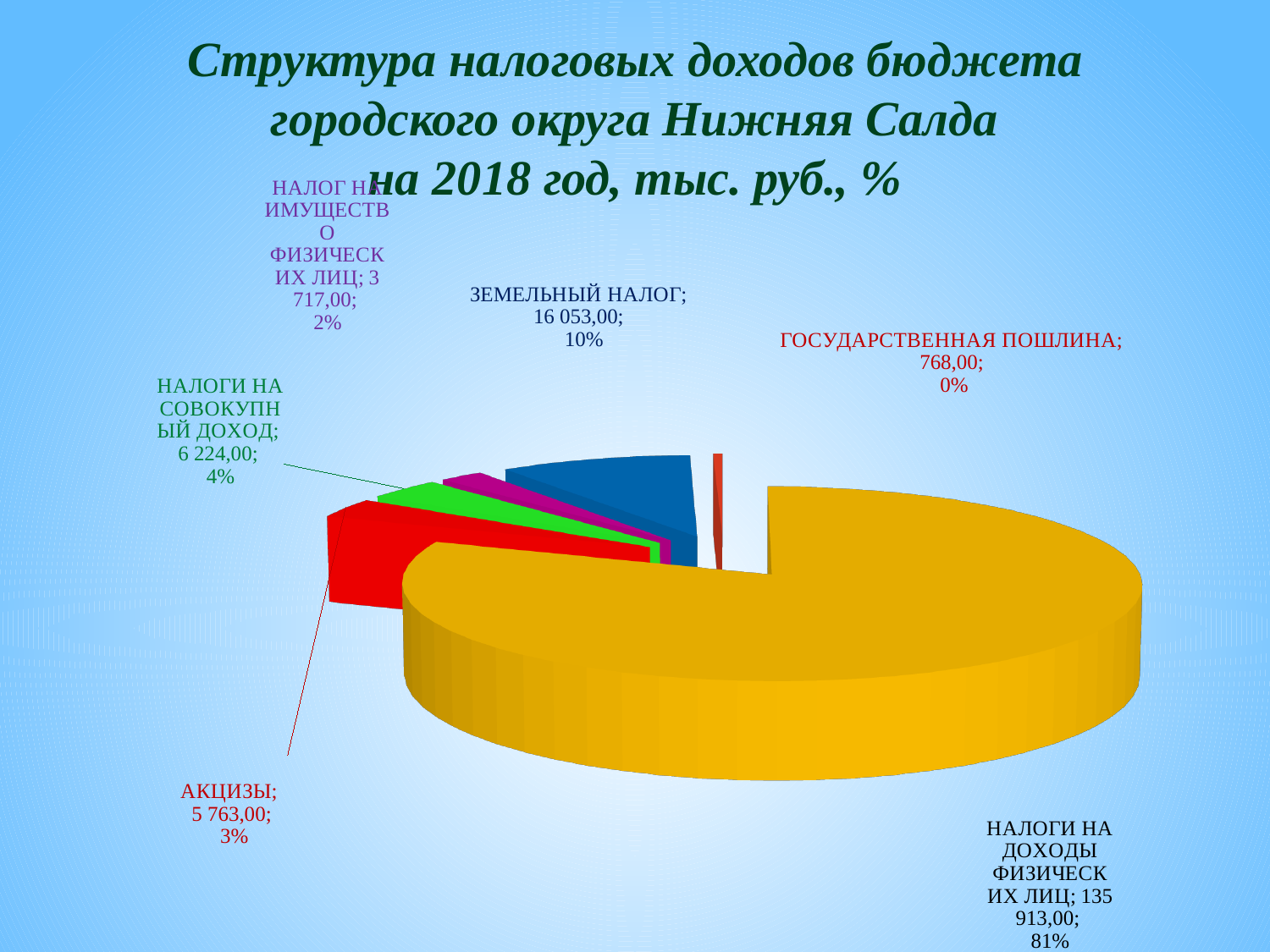
What is the difference between the values for ЗЕМЕЛЬНЫЙ НАЛОГ and НАЛОГИ НА СОВОКУПНЫЙ ДОХОД? 9 829,00 What is the value for ЗЕМЕЛЬНЫЙ НАЛОГ? 16 053,00 What year does the chart title refer to? 2018 What is the value for АКЦИЗЫ? 5 763,00 What share of the pie does НАЛОГИ НА ДОХОДЫ ФИЗИЧЕСКИХ ЛИЦ represent? 81% What is the value for ГОСУДАРСТВЕННАЯ ПОШЛИНА? 768,00 Which category has the largest slice of the pie? НАЛОГИ НА ДОХОДЫ ФИЗИЧЕСКИХ ЛИЦ Which is larger, the value for АКЦИЗЫ or the value for НАЛОГ НА ИМУЩЕСТВО ФИЗИЧЕСКИХ ЛИЦ? АКЦИЗЫ What percentage is shown for НАЛОГИ НА СОВОКУПНЫЙ ДОХОД? 4% What kind of chart is shown on the slide? pie chart Which category has the smallest slice of the pie? ГОСУДАРСТВЕННАЯ ПОШЛИНА How many slices does the pie chart have? 6